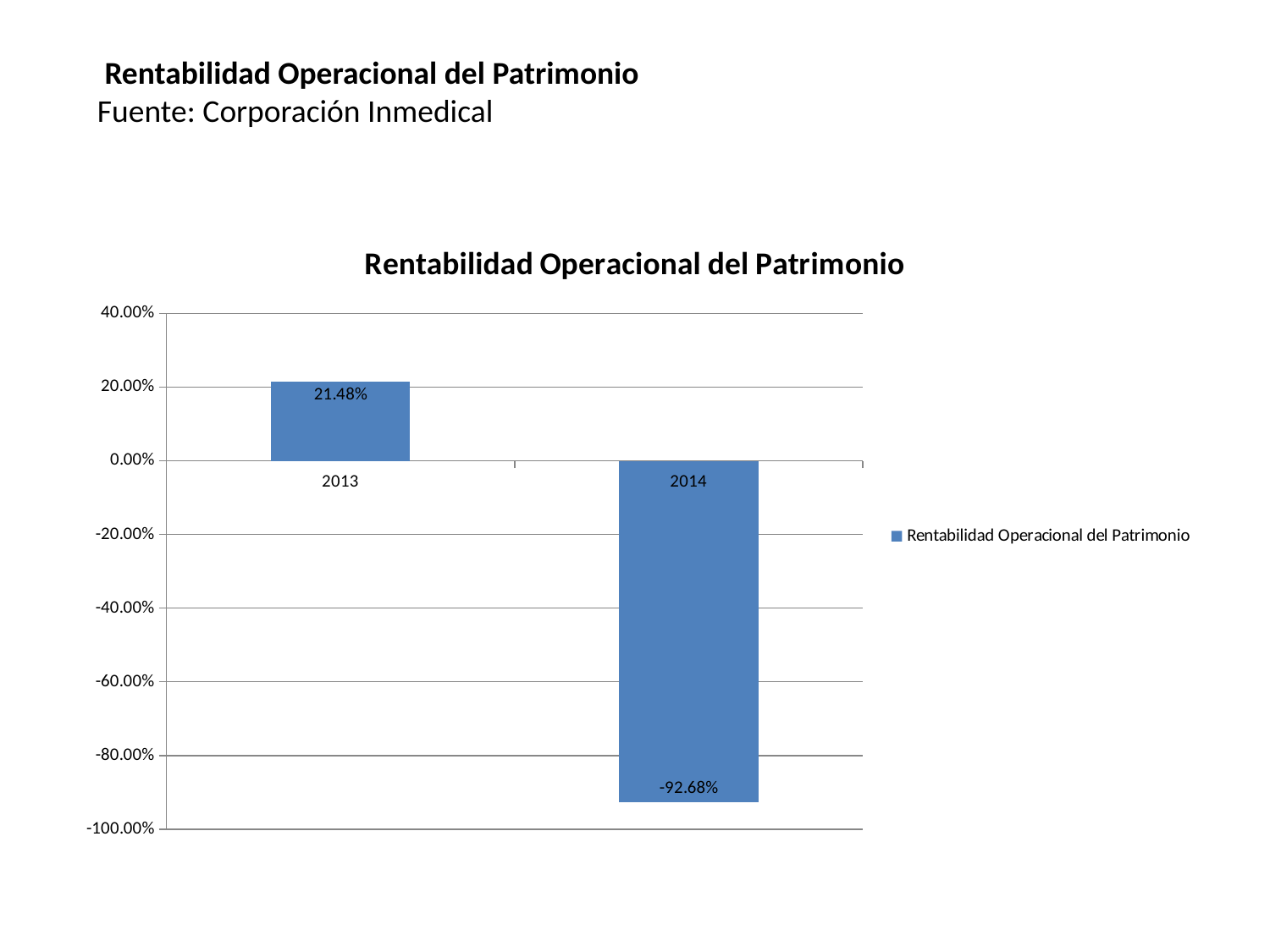
Which is larger, the value for 2013 or the value for 2014? 2013 What is the difference between the 2013 value and the 2014 value? 114.16% Which year has the lowest value? 2014 What is the value for 2014? -92.68% Do the values rise or fall from 2013 to 2014? fall How many series does the legend list? 1 What is the value for 2013? 21.48% Is the value for 2013 greater or less than 20.00%? greater Which year has the highest value? 2013 Is the value for 2014 greater or less than -80.00%? less What kind of chart is shown? bar chart How many years are shown on the chart? 2